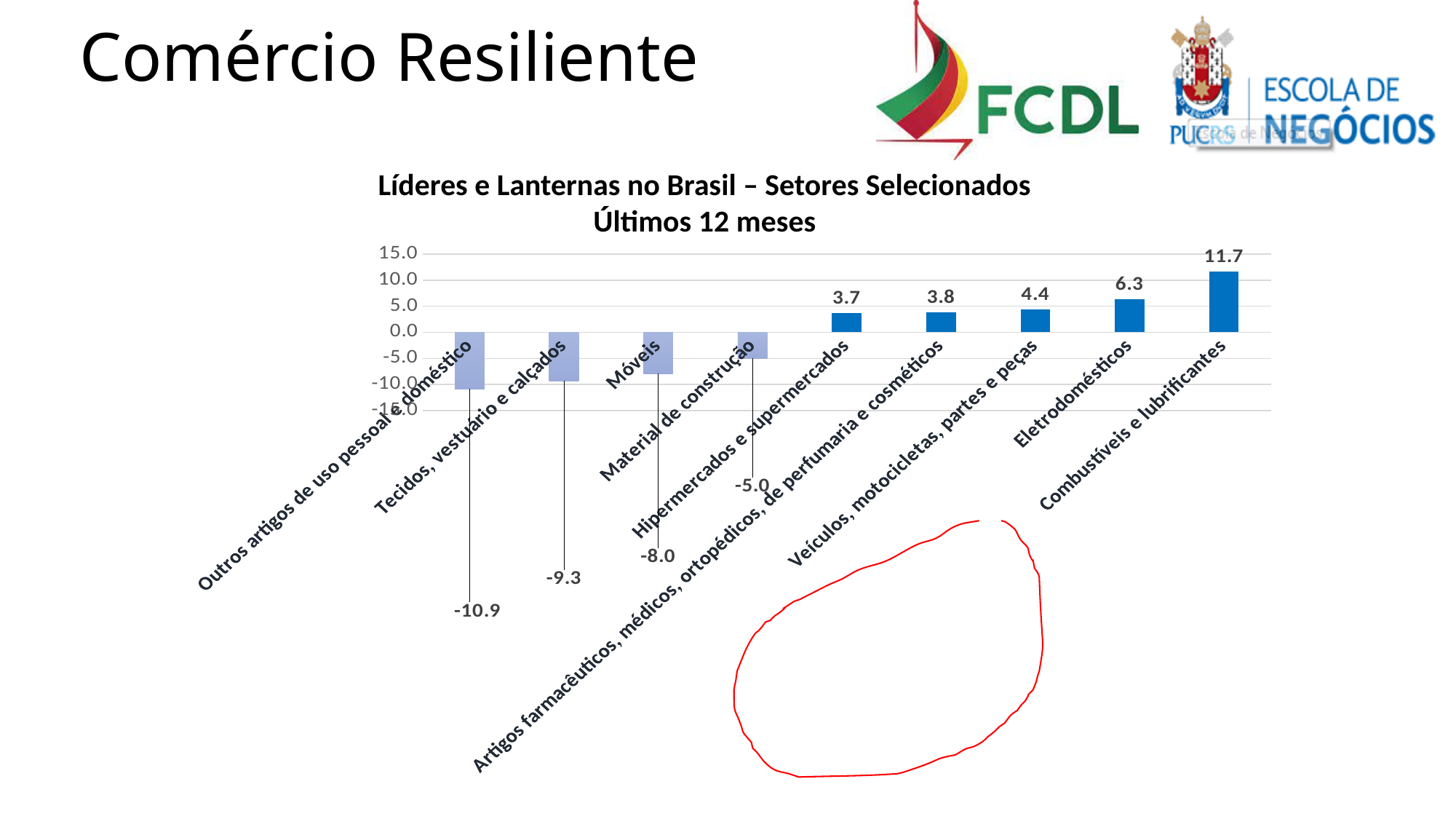
What kind of chart is shown on the slide? Bar chart What is the value for Outros artigos de uso pessoal e doméstico? -10.9 Which category has the lowest value? Outros artigos de uso pessoal e doméstico How many categories are shown in the chart? 9 Which is larger, the value for Veículos, motocicletas, partes e peças or the value for Hipermercados e supermercados? Veículos, motocicletas, partes e peças What is the difference between the values for Combustíveis e lubrificantes and Eletrodomésticos? 5.4 What is the value for Eletrodomésticos? 6.3 What is the value for Combustíveis e lubrificantes? 11.7 What is the value for Móveis? -8.0 Which category has the highest value? Combustíveis e lubrificantes What is the value for Material de construção? -5.0 What is the title of the chart? Líderes e Lanternas no Brasil – Setores Selecionados Últimos 12 meses